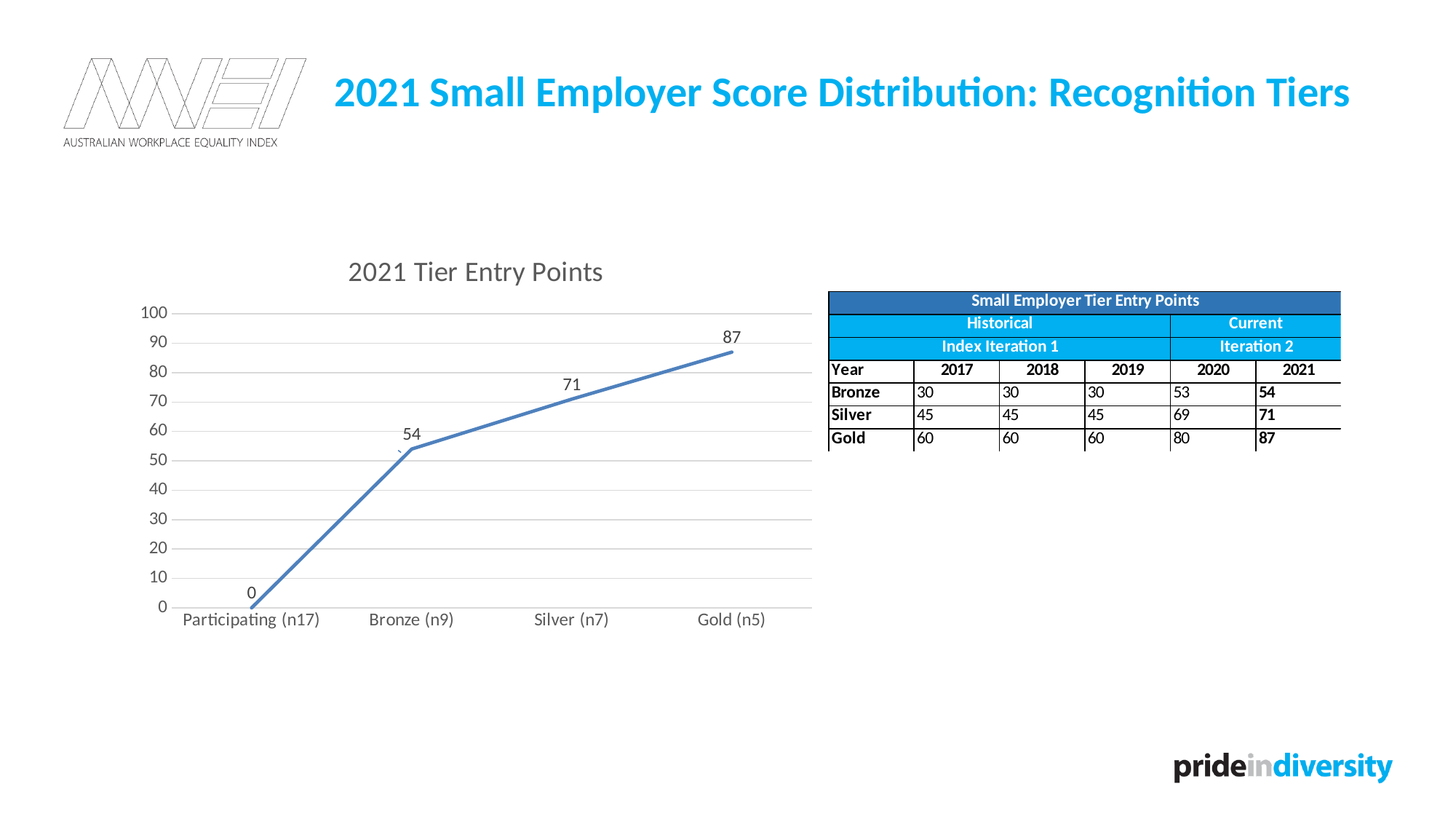
What is the value for Participating (n17) in the 2021 Tier Entry Points chart? 0 What is the value for Gold (n5) in the 2021 Tier Entry Points chart? 87 Which category has the highest value in the 2021 Tier Entry Points chart? Gold (n5) What kind of chart is the 2021 Tier Entry Points chart? Line chart What is the difference between the values for Silver (n7) and Bronze (n9) in the 2021 Tier Entry Points chart? 17 What is the value for Silver (n7) in the 2021 Tier Entry Points chart? 71 Which category has the lowest value in the 2021 Tier Entry Points chart? Participating (n17) Which is larger in the 2021 Tier Entry Points chart, the value for Bronze (n9) or Silver (n7)? Silver (n7) What is the difference between the values for Gold (n5) and Silver (n7) in the 2021 Tier Entry Points chart? 16 What is the value for Bronze (n9) in the 2021 Tier Entry Points chart? 54 Do the values in the 2021 Tier Entry Points chart rise or fall from left to right along the x axis? Rise How many categories are plotted on the x axis of the 2021 Tier Entry Points chart? 4